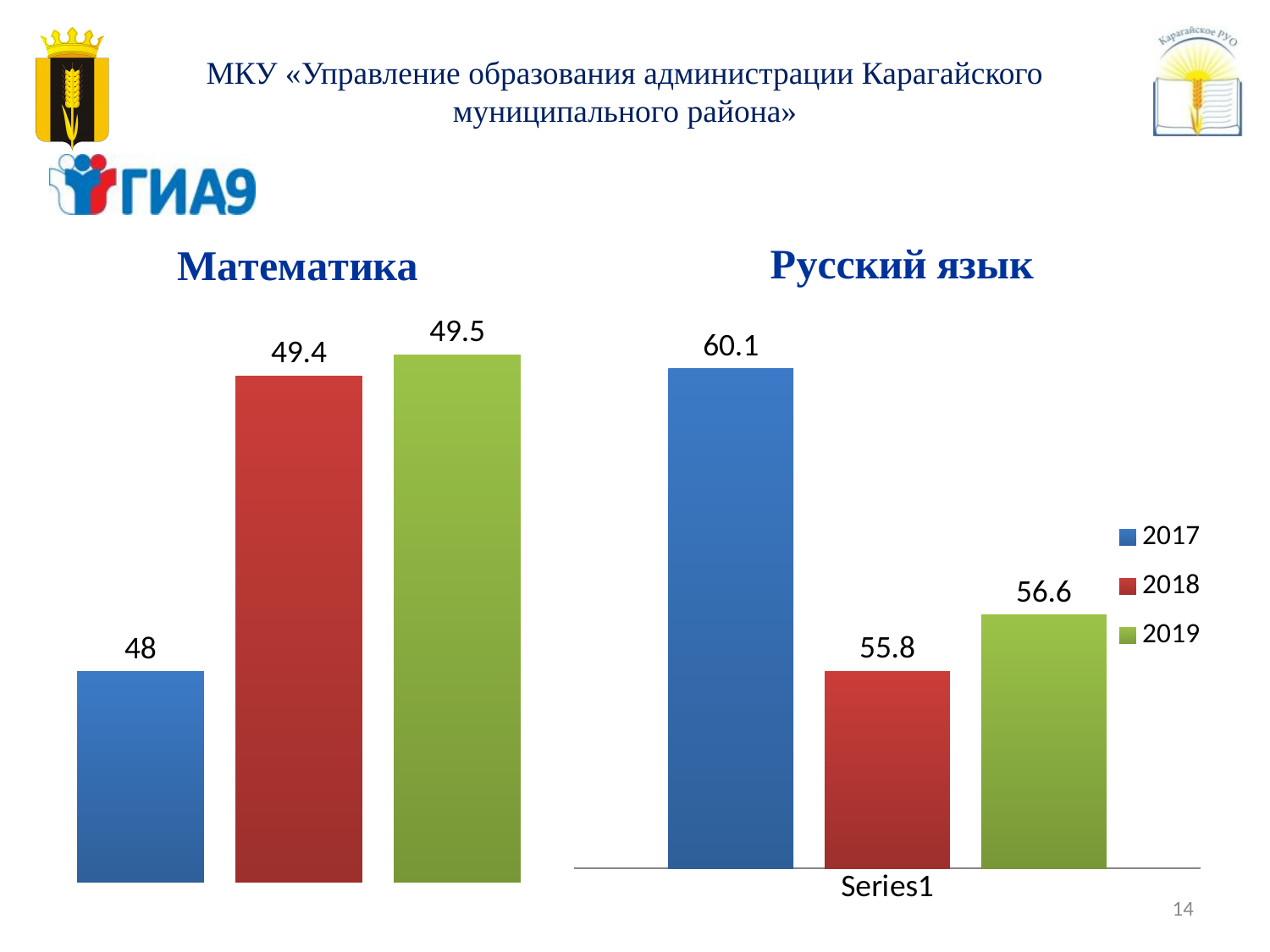
In the Русский язык chart, what is the value for 2019? 56.6 How many series does the legend on the slide list? 3 In the Русский язык chart, which year has the lowest value? 2018 In the Русский язык chart, what is the value for 2017? 60.1 In the Русский язык chart, what is the difference between the 2017 and 2018 values? 4.3 In the Математика chart, what is the difference between the green (2019) bar and the blue (2017) bar? 1.5 In the Русский язык chart, which year has the highest value? 2017 In the Математика chart, what is the value of the red (2018) bar? 49.4 In the Русский язык chart, what is the value for 2018? 55.8 In the Математика chart, what is the value of the blue (2017) bar? 48 In the Математика chart, what is the value of the green (2019) bar? 49.5 In the Математика chart, which bar has the lowest value? The blue (2017) bar, 48